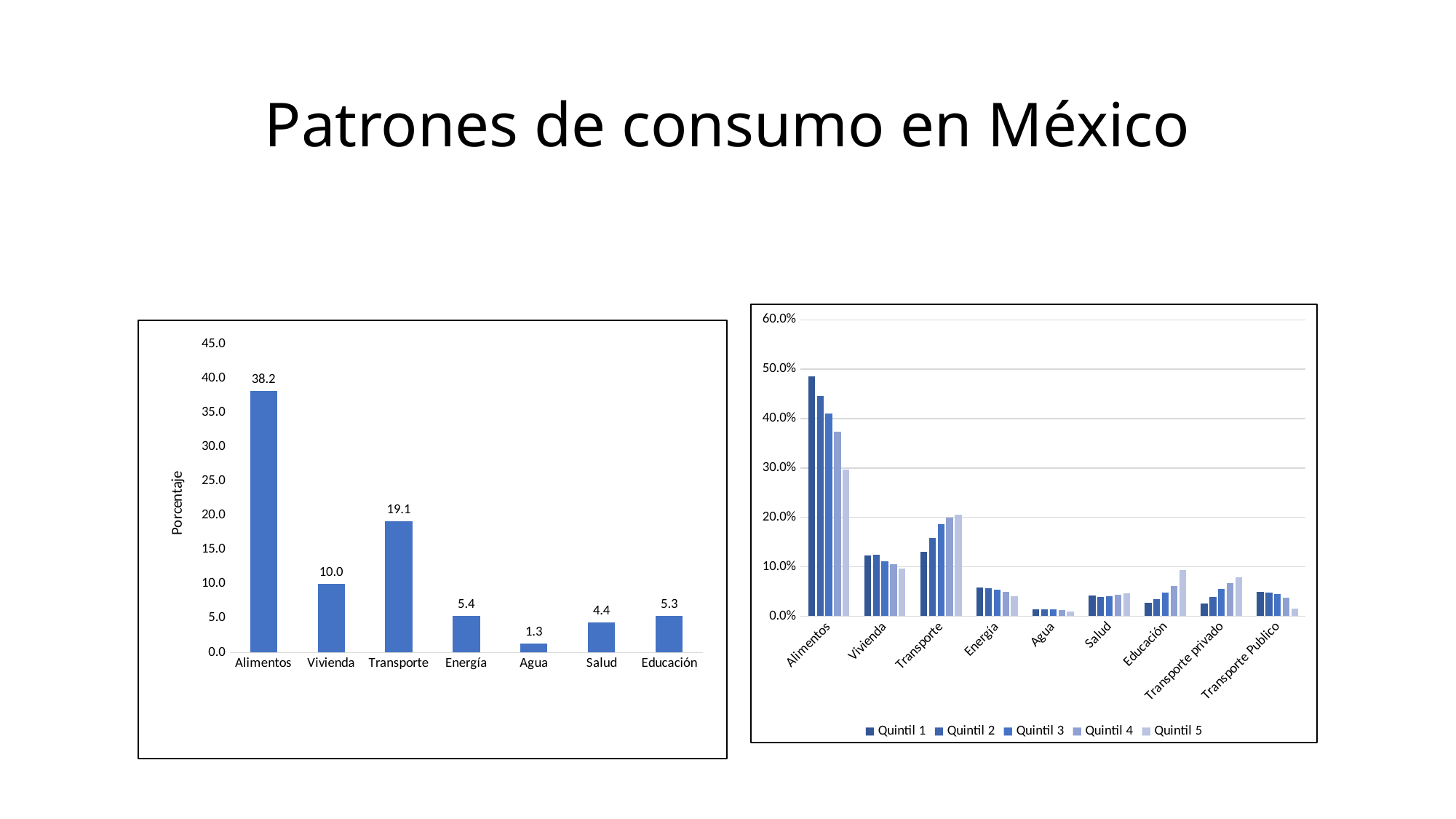
In the right chart, is the value for Quintil 1 in Alimentos greater or less than 40.0%? greater In the left chart, which category has the lowest value? Agua In the left chart, which is larger, the value for Salud or the value for Educación? Educación In the left chart, what is the value for Transporte? 19.1 In the left chart, what is the value for Alimentos? 38.2 In the right chart, how many series does the legend list? 5 In the right chart, how many categories are shown on the x axis? 9 In the left chart, what is the difference between the values for Alimentos and Transporte? 19.1 In the left chart, which category has the highest value? Alimentos In the left chart, what is the value for Agua? 1.3 What kind of chart is the left chart? bar chart In the left chart, how many categories are shown on the x axis? 7